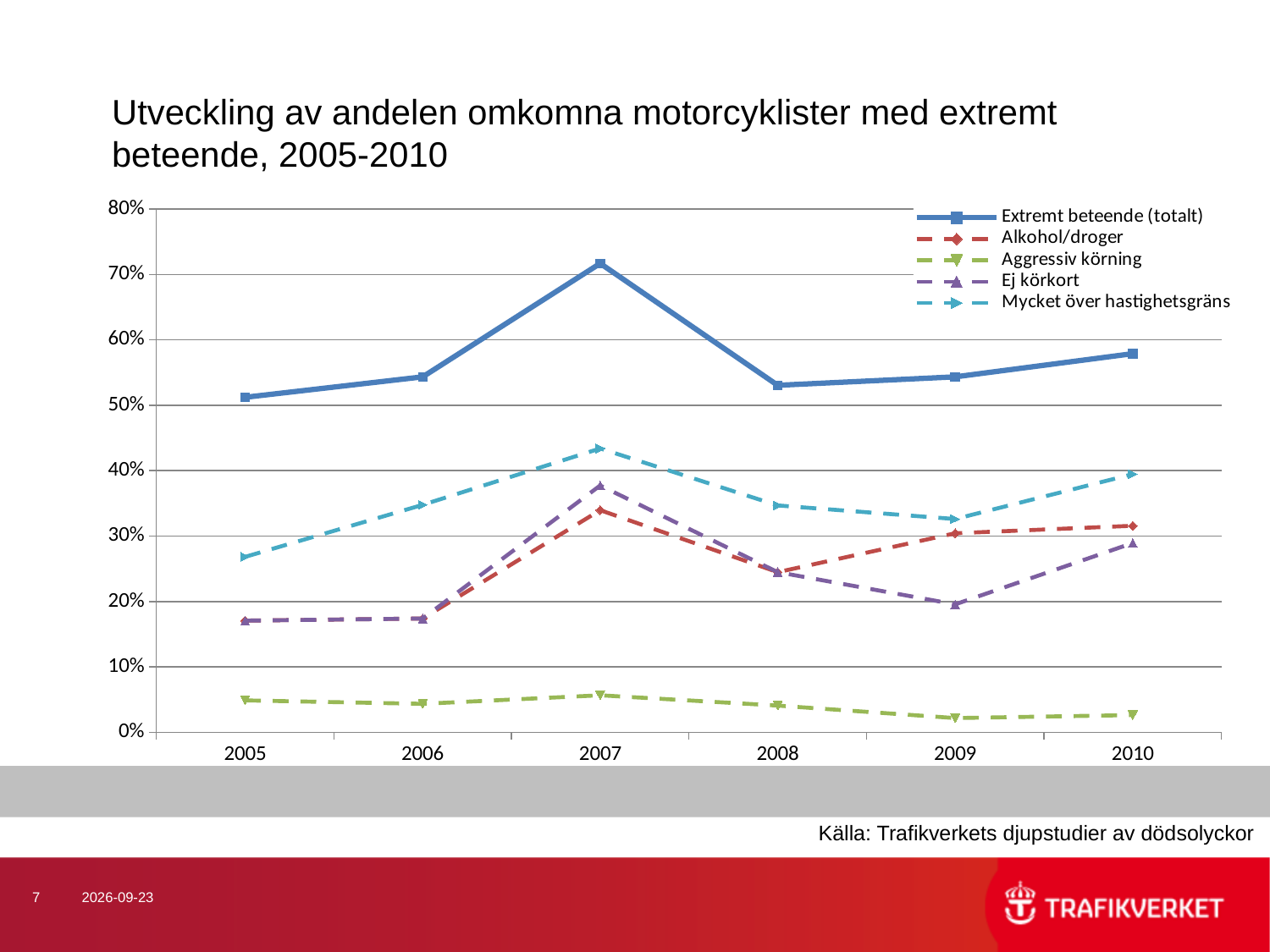
How many series does the legend list? 5 Which series has the lowest values across all years? Aggressiv körning Is the value for Alkohol/droger in 2005 greater or less than 20%? less Which legend entry is drawn as the solid blue line? Extremt beteende (totalt) In 2010, which is larger: Mycket över hastighetsgräns or Alkohol/droger? Mycket över hastighetsgräns Is the value for Mycket över hastighetsgräns in 2005 greater or less than 30%? less In which year is the value for Extremt beteende (totalt) highest? 2007 Does the value for Extremt beteende (totalt) rise or fall from 2008 to 2010? rise Is the value for Aggressiv körning in 2009 greater or less than 10%? less How many years are shown on the x axis? 6 What kind of chart is shown on the slide? line chart